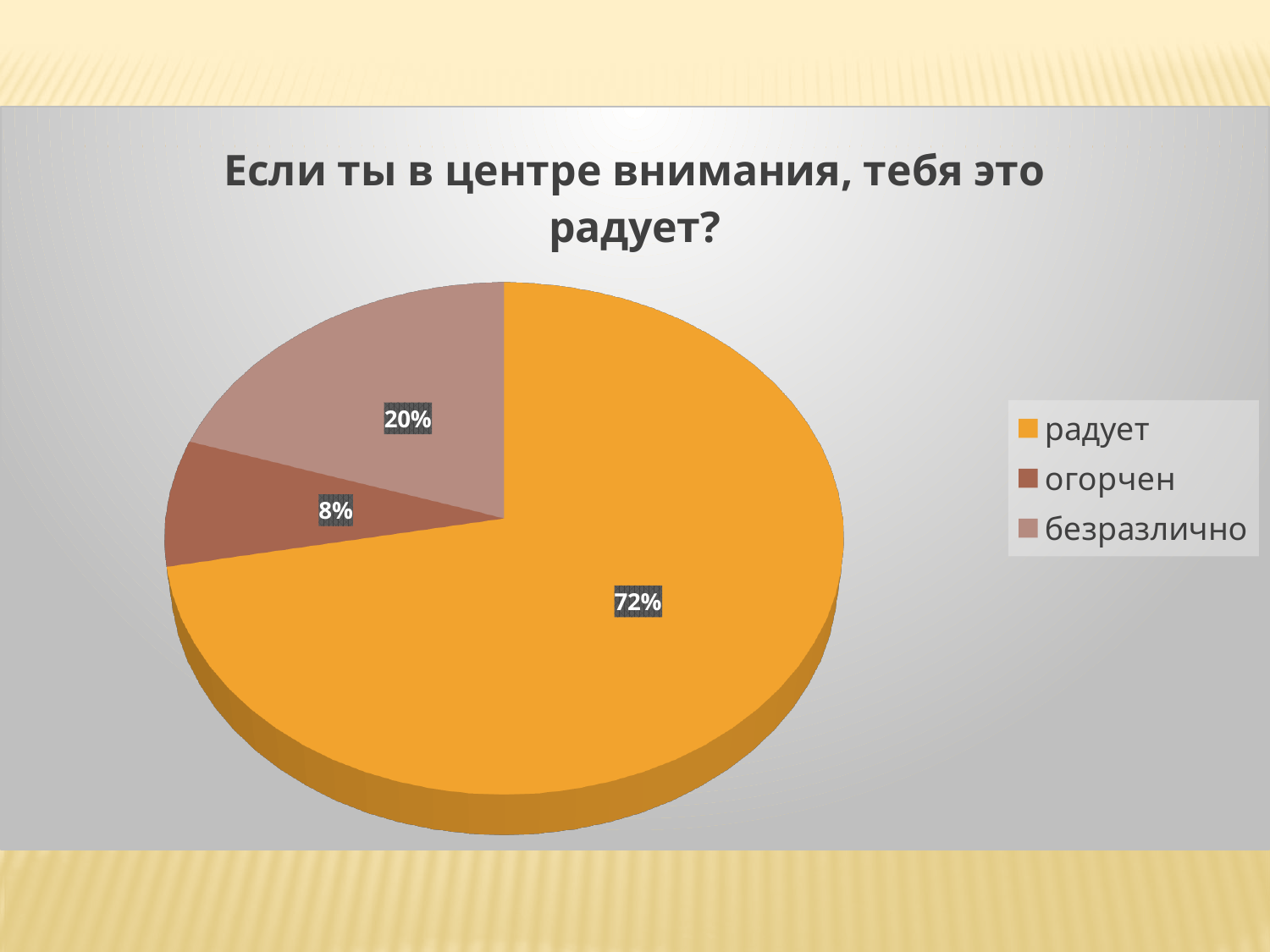
What share of the pie does "безразлично" take? 20% What share of the pie does "огорчен" take? 8% What is the title of the chart? Если ты в центре внимания, тебя это радует? What share of the pie does "радует" take? 72% Which category has the largest slice? радует What is the difference between the shares of "радует" and "безразлично"? 52% What colour is the slice for "радует"? orange How many entries does the legend list? 3 Which category has the smallest slice? огорчен How many slices does the pie chart have? 3 Which is larger, the share for "безразлично" or the share for "огорчен"? безразлично What type of chart is shown on the slide? pie chart